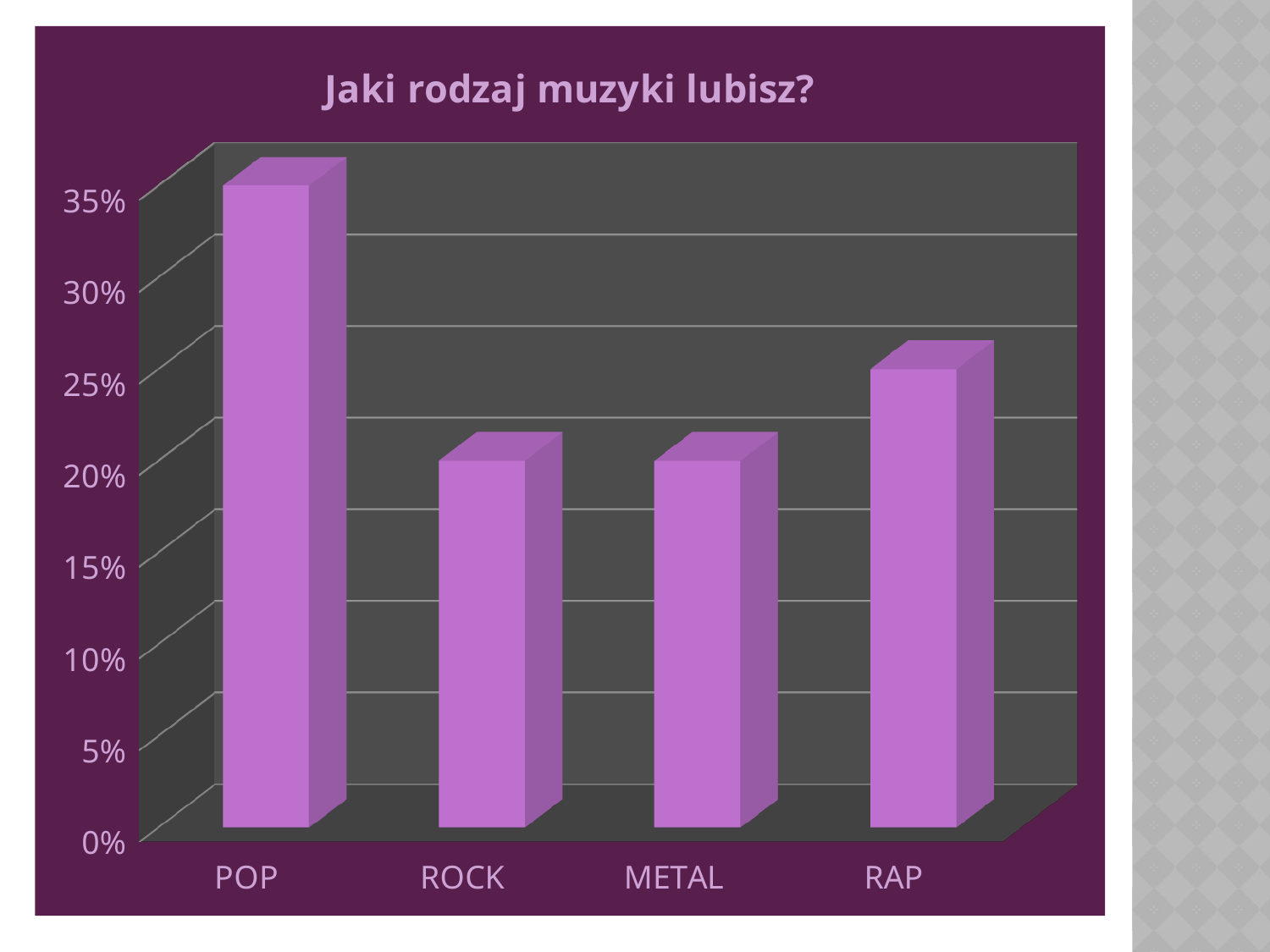
What kind of chart is shown on the slide? bar chart Which is larger, the value for POP or the value for RAP? POP How many music categories are shown on the x axis? 4 Which is larger, the value for RAP or the value for ROCK? RAP Is the value for POP greater or less than 30%? greater What is the highest value shown on the vertical axis? 35% Is the value for RAP greater or less than 30%? less Is the value for METAL greater or less than 25%? less What is the title of the chart? Jaki rodzaj muzyki lubisz? Which category has the highest value? POP